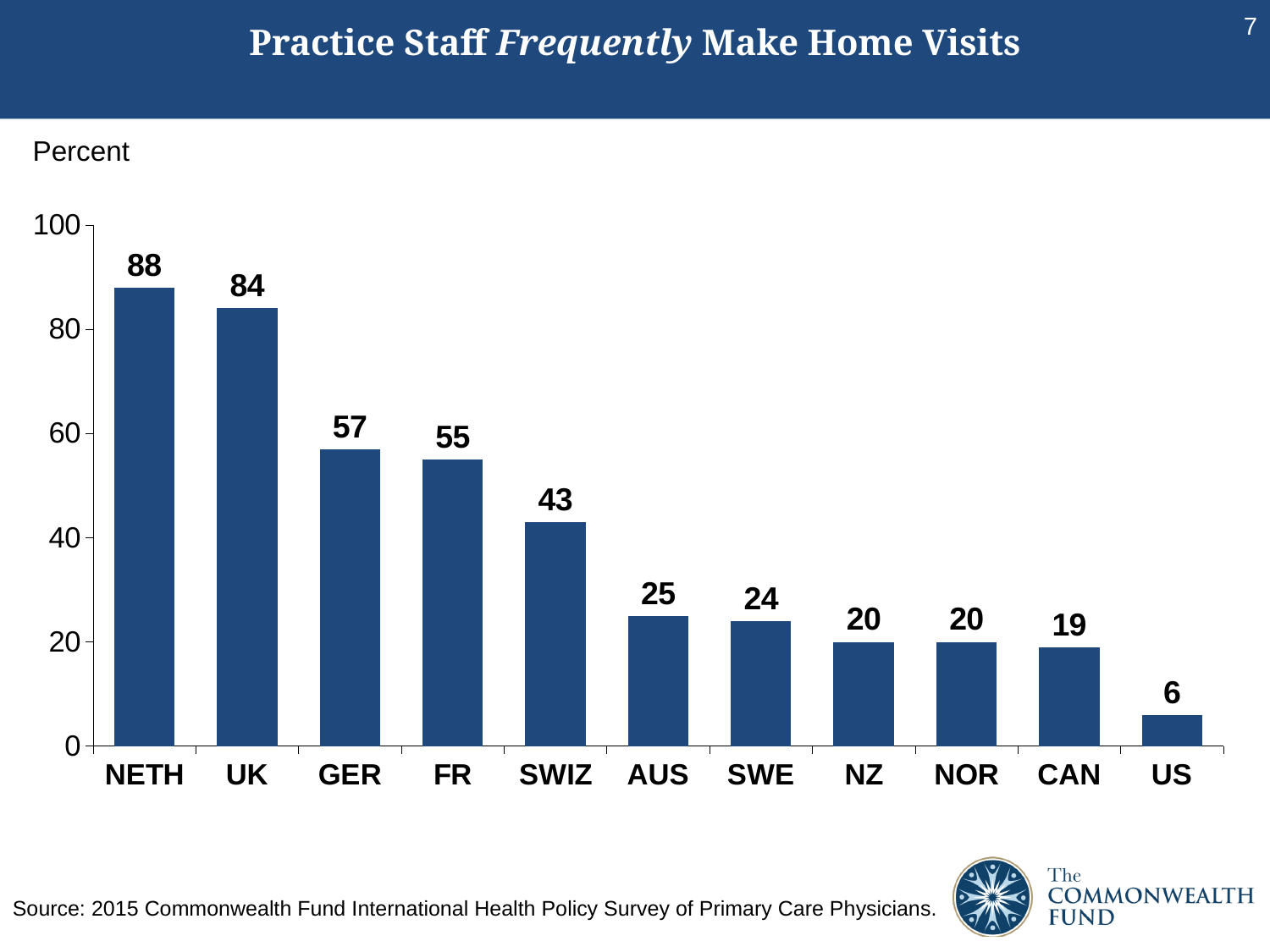
How many countries are shown on the chart? 11 What is the difference between the values for GER and US? 51 Which country has the highest value? NETH What is the value for NETH? 88 Is the value for FR greater or less than 60? less What kind of chart is shown on the slide? bar chart What is the value for CAN? 19 What is the difference between the values for NETH and UK? 4 Which country has the lowest value? US What is the value for SWIZ? 43 What is the title of the chart? Practice Staff Frequently Make Home Visits Which is larger, the value for AUS or the value for SWE? AUS